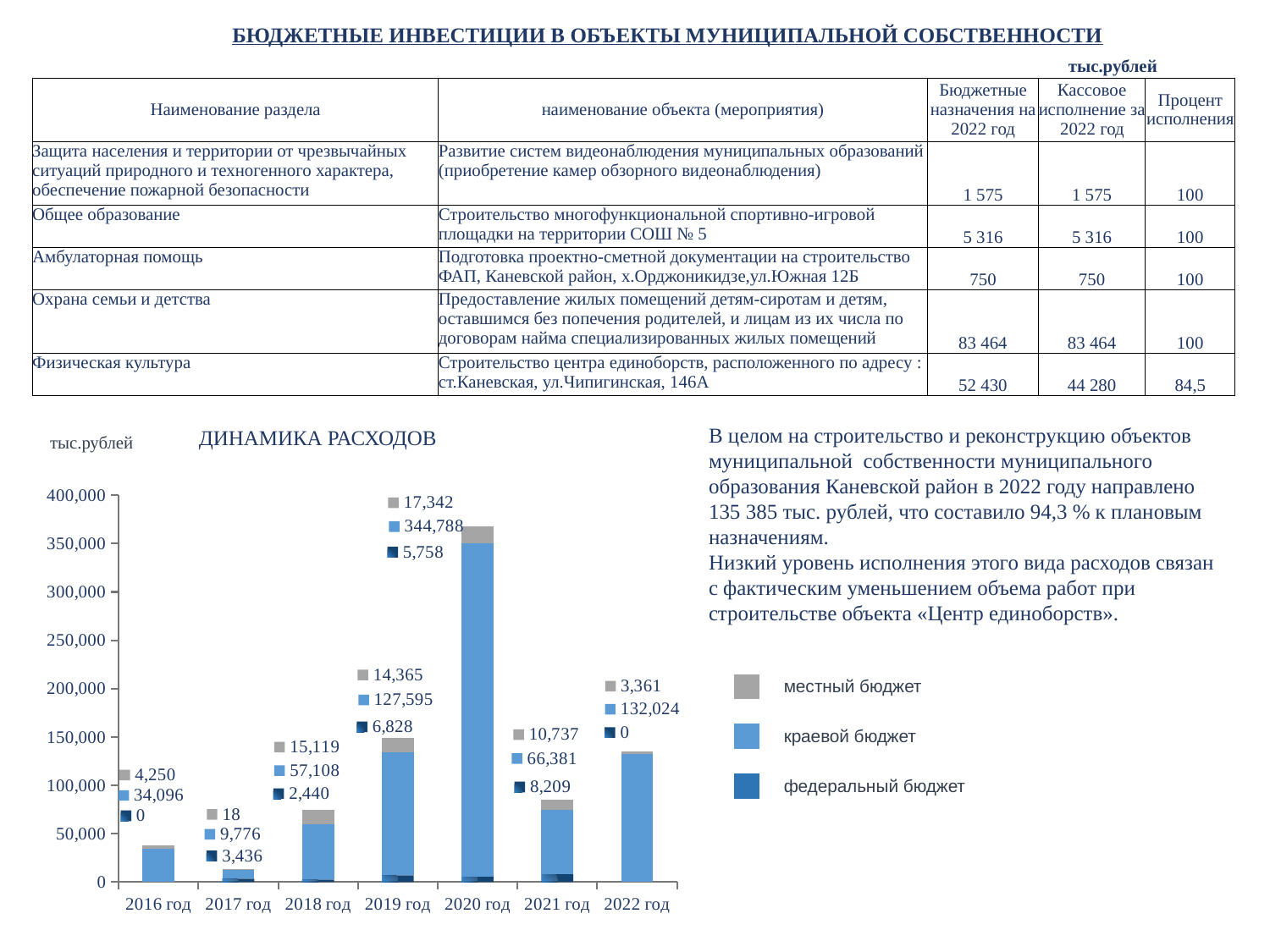
In the ДИНАМИКА РАСХОДОВ chart, what is the total of the stacked bar for 2022 год? 135,385 In the ДИНАМИКА РАСХОДОВ chart, what is the difference between the краевой бюджет values for 2022 год and 2021 год? 65,643 How many series does the legend of the ДИНАМИКА РАСХОДОВ chart list? 3 In the ДИНАМИКА РАСХОДОВ chart, what is the total of the stacked bar for 2017 год? 13,230 How many years are shown on the x axis of the ДИНАМИКА РАСХОДОВ chart? 7 In the ДИНАМИКА РАСХОДОВ chart, what is the value for краевой бюджет in 2020 год? 344,788 In the ДИНАМИКА РАСХОДОВ chart, what is the value for местный бюджет in 2018 год? 15,119 In the ДИНАМИКА РАСХОДОВ chart, what is the value for федеральный бюджет in 2021 год? 8,209 In the ДИНАМИКА РАСХОДОВ chart, which is larger: федеральный бюджет in 2019 год or in 2020 год? 2019 год In the ДИНАМИКА РАСХОДОВ chart, which year has the lowest value for местный бюджет? 2017 год In the ДИНАМИКА РАСХОДОВ chart, which year has the highest value for краевой бюджет? 2020 год What kind of chart is ДИНАМИКА РАСХОДОВ? Stacked bar chart